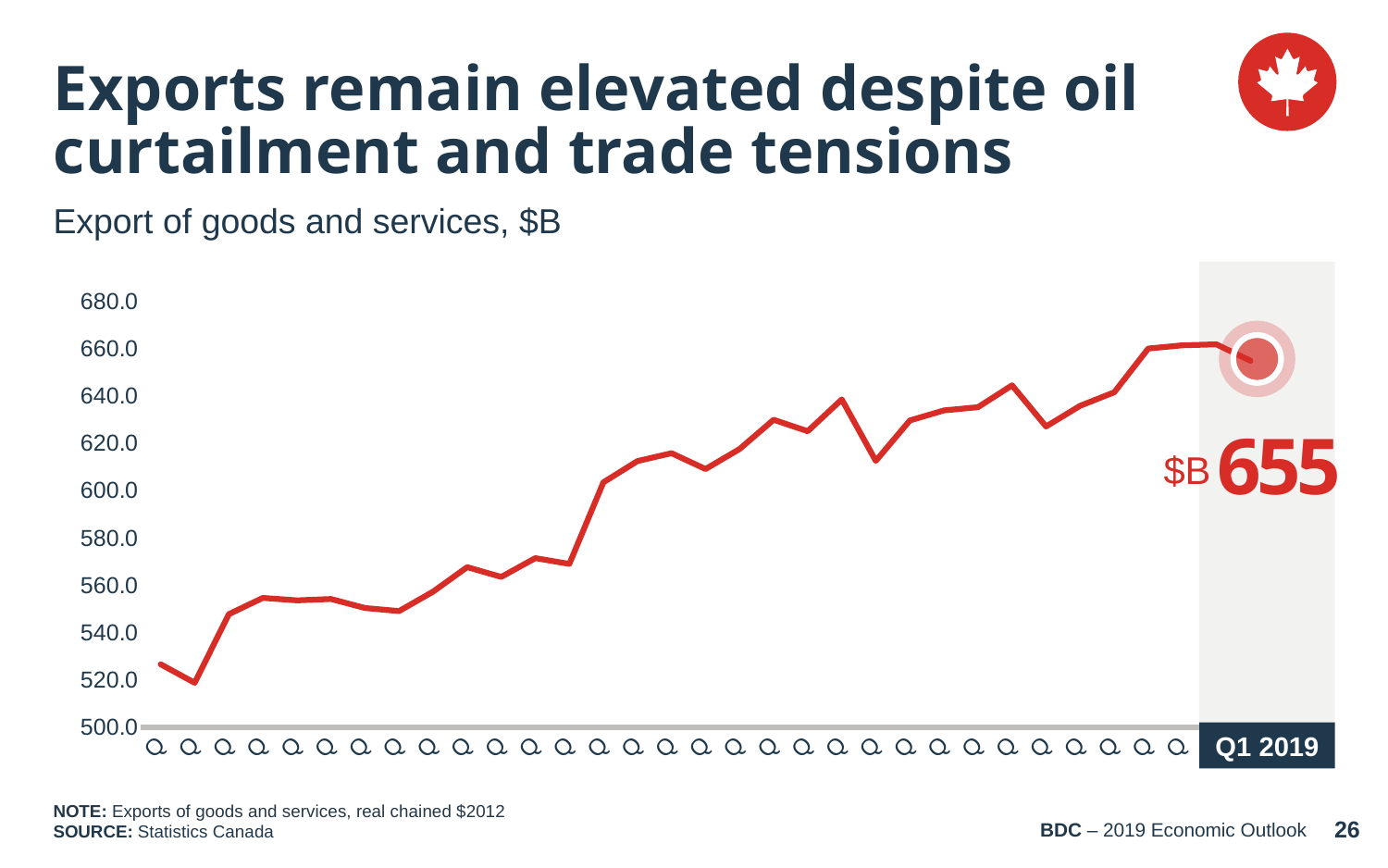
Is the lowest value on the chart greater or less than 540? less What is the subtitle describing the chart's data? Export of goods and services, $B Is the value for Q1 2019 greater or less than 640? greater What colour is the plotted line? red How many lines (series) are plotted on the chart? 1 Is the value for Q1 2019 greater or less than 660? less Do the export values generally rise or fall from left to right along the x axis? rise What kind of chart is shown on the slide? line chart What is the value of exports of goods and services for Q1 2019? $B 655